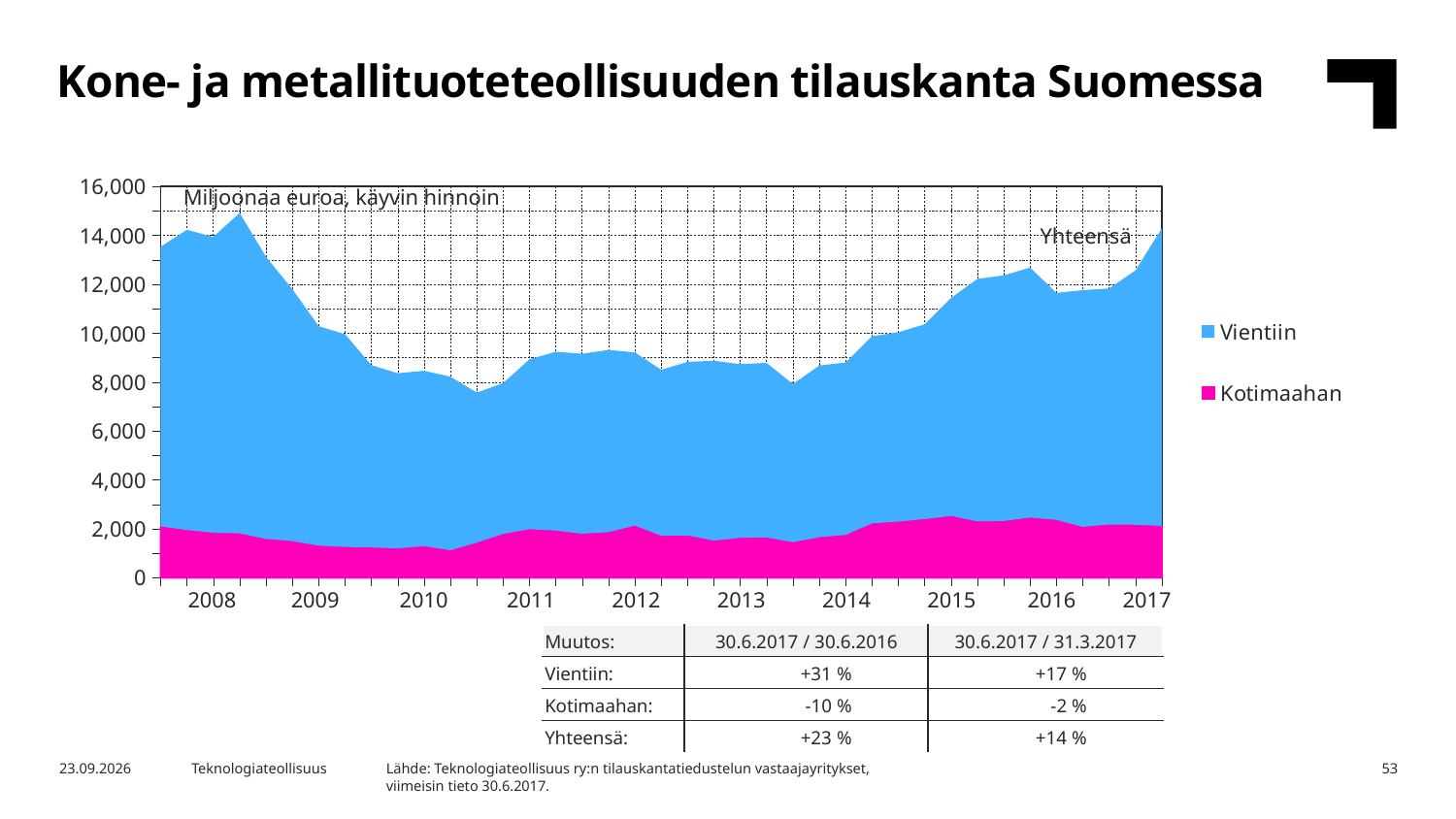
What are the two series named in the chart legend? Vientiin and Kotimaahan Is the Kotimaahan value at the end of 2017 greater or less than 4,000? less Is the total (Yhteensä) value at the start of 2008 greater or less than 12,000? greater How many years are labelled on the x axis of the chart? 10 How many series does the chart legend list? 2 Is the total (Yhteensä) value in the middle of 2010 greater or less than 10,000? less What kind of chart is shown on the slide? Stacked area chart Does the total (Yhteensä) value rise or fall from 2008 to 2010? fall What unit is stated in the chart's subtitle? Miljoonaa euroa, käyvin hinnoin Which is larger at the end of 2017, the Vientiin series or the Kotimaahan series? Vientiin Does the total (Yhteensä) value rise or fall from 2014 to 2017? rise